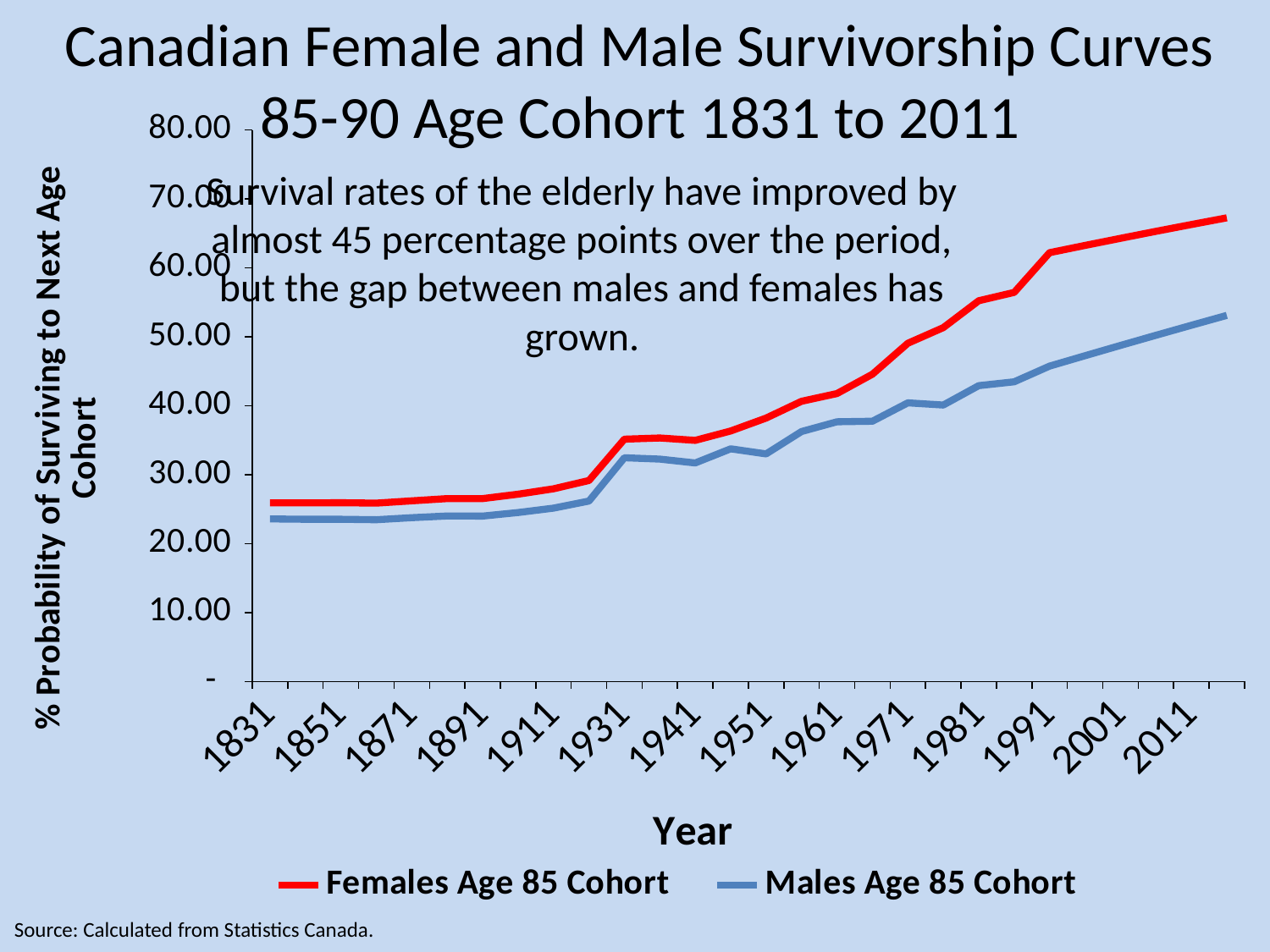
Is the value for Females Age 85 Cohort in 2011 greater or less than 60.00? greater How many year labels are shown along the x axis? 14 Is the value for Males Age 85 Cohort in 1951 greater or less than 40.00? less What are the two series named in the legend? Females Age 85 Cohort and Males Age 85 Cohort What kind of chart is shown on the slide? Line chart Is the value for Females Age 85 Cohort in 1831 greater or less than 30.00? less Do the values for Females Age 85 Cohort rise or fall from 1831 to 2011? Rise How many series does the legend list? 2 What is the label of the x axis? Year Which series has the higher value in 2011, Females Age 85 Cohort or Males Age 85 Cohort? Females Age 85 Cohort